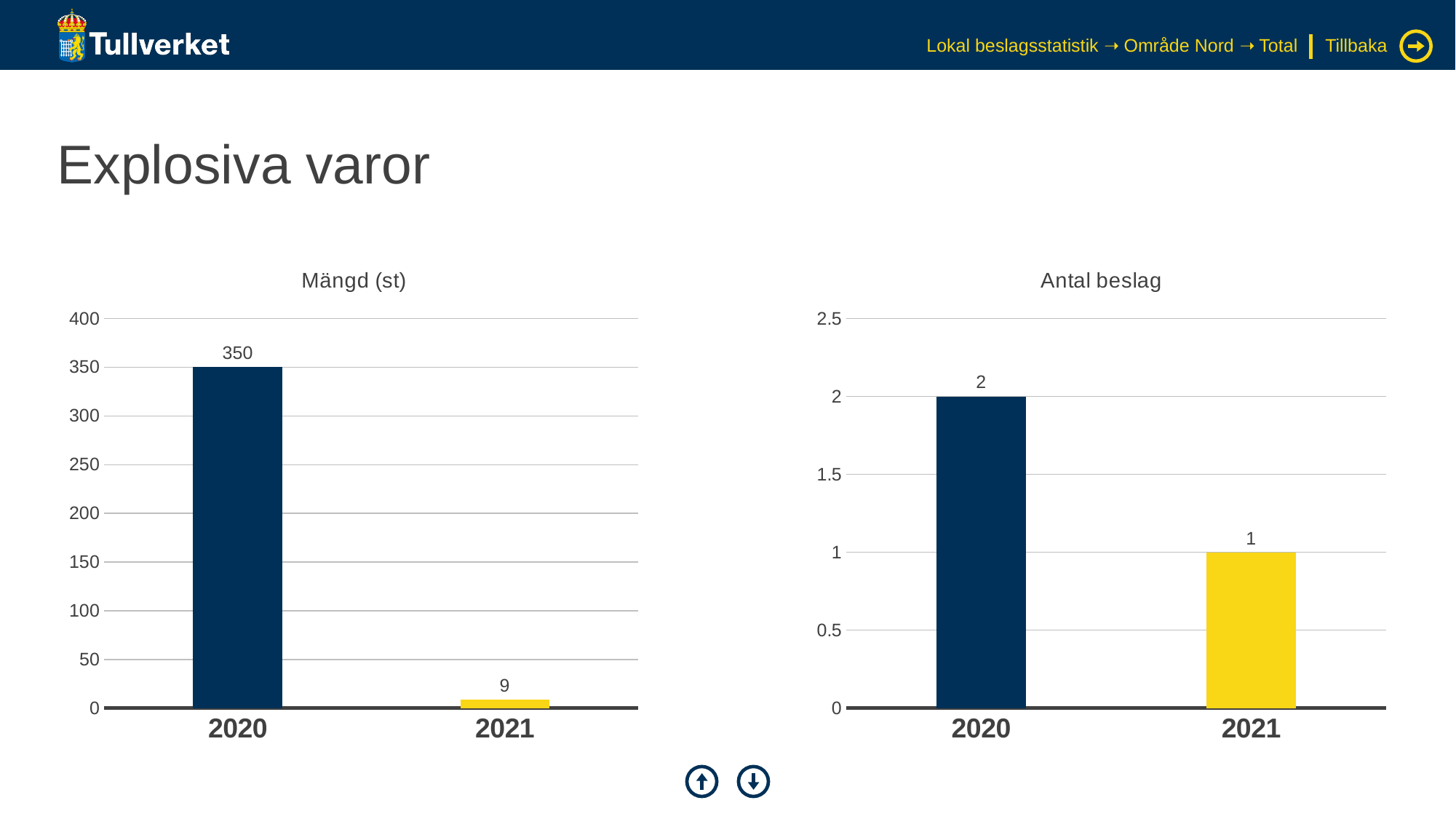
In the "Mängd (st)" chart, what is the value for 2021? 9 What kind of chart is the "Antal beslag" chart? bar chart In the "Mängd (st)" chart, is the value for 2020 greater or less than 300? greater How many years are shown in the "Mängd (st)" chart? 2 In the "Mängd (st)" chart, which year has the highest value? 2020 In the "Antal beslag" chart, which year has the lowest value? 2021 In the "Antal beslag" chart, which year has the larger value, 2020 or 2021? 2020 In the "Antal beslag" chart, what is the difference between the values for 2020 and 2021? 1 In the "Antal beslag" chart, what is the value for 2021? 1 In the "Antal beslag" chart, what is the value for 2020? 2 In the "Mängd (st)" chart, what is the value for 2020? 350 In the "Mängd (st)" chart, what is the difference between the values for 2020 and 2021? 341